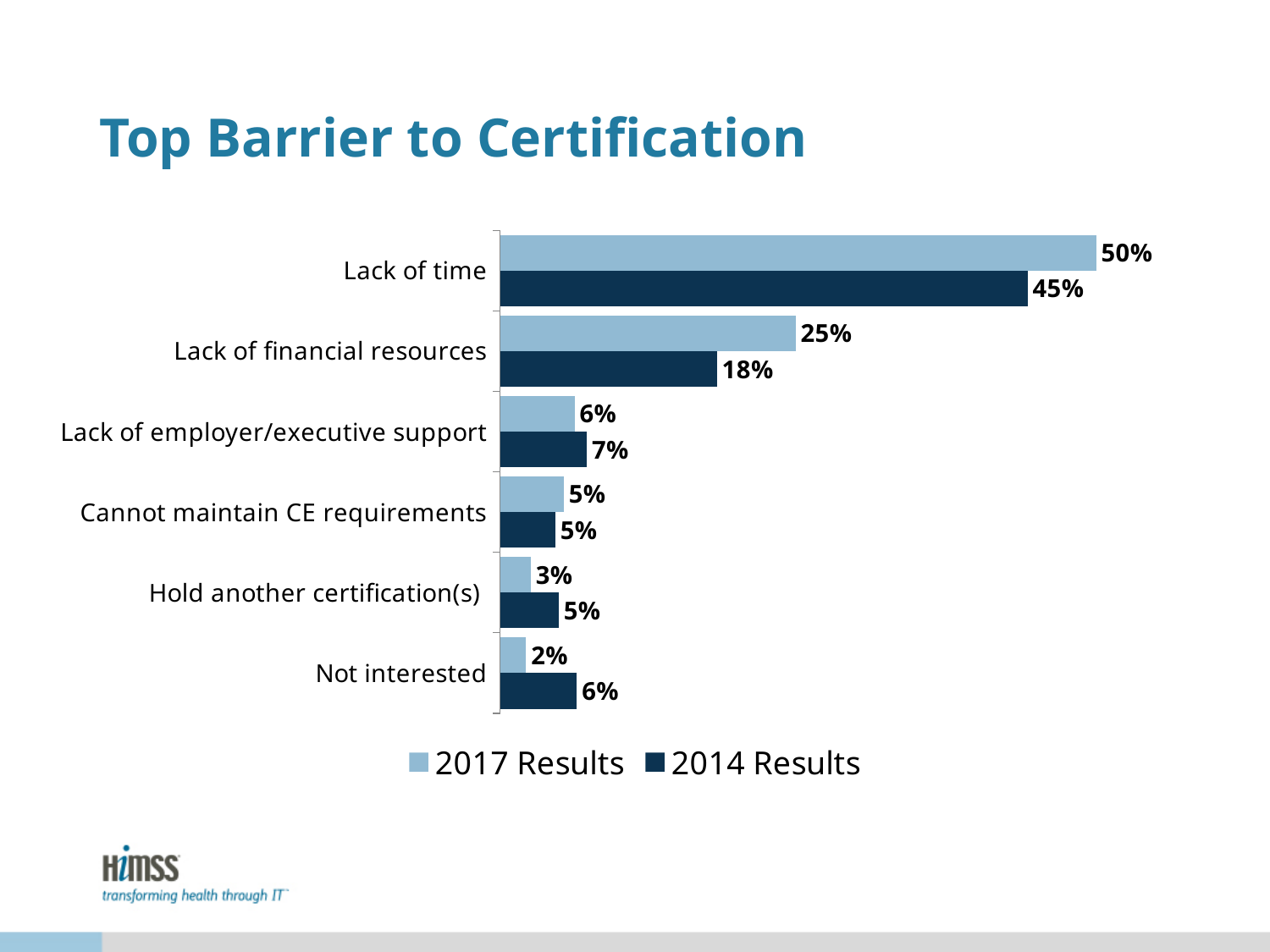
What is the 2014 Results value for Not interested? 6% Which barrier has the highest 2017 Results value? Lack of time What is the 2017 Results value for Lack of time? 50% What is the title of the chart? Top Barrier to Certification For Not interested, which is larger: the 2017 Results or the 2014 Results? 2014 Results What is the difference between the 2017 and 2014 Results for Lack of financial resources? 7% How many barrier categories are shown in the chart? 6 What is the 2014 Results value for Lack of financial resources? 18% Which barrier has the lowest 2017 Results value? Not interested What type of chart is shown on the slide? Bar chart How many series does the legend list? 2 What is the difference between the 2017 and 2014 Results for Lack of time? 5%